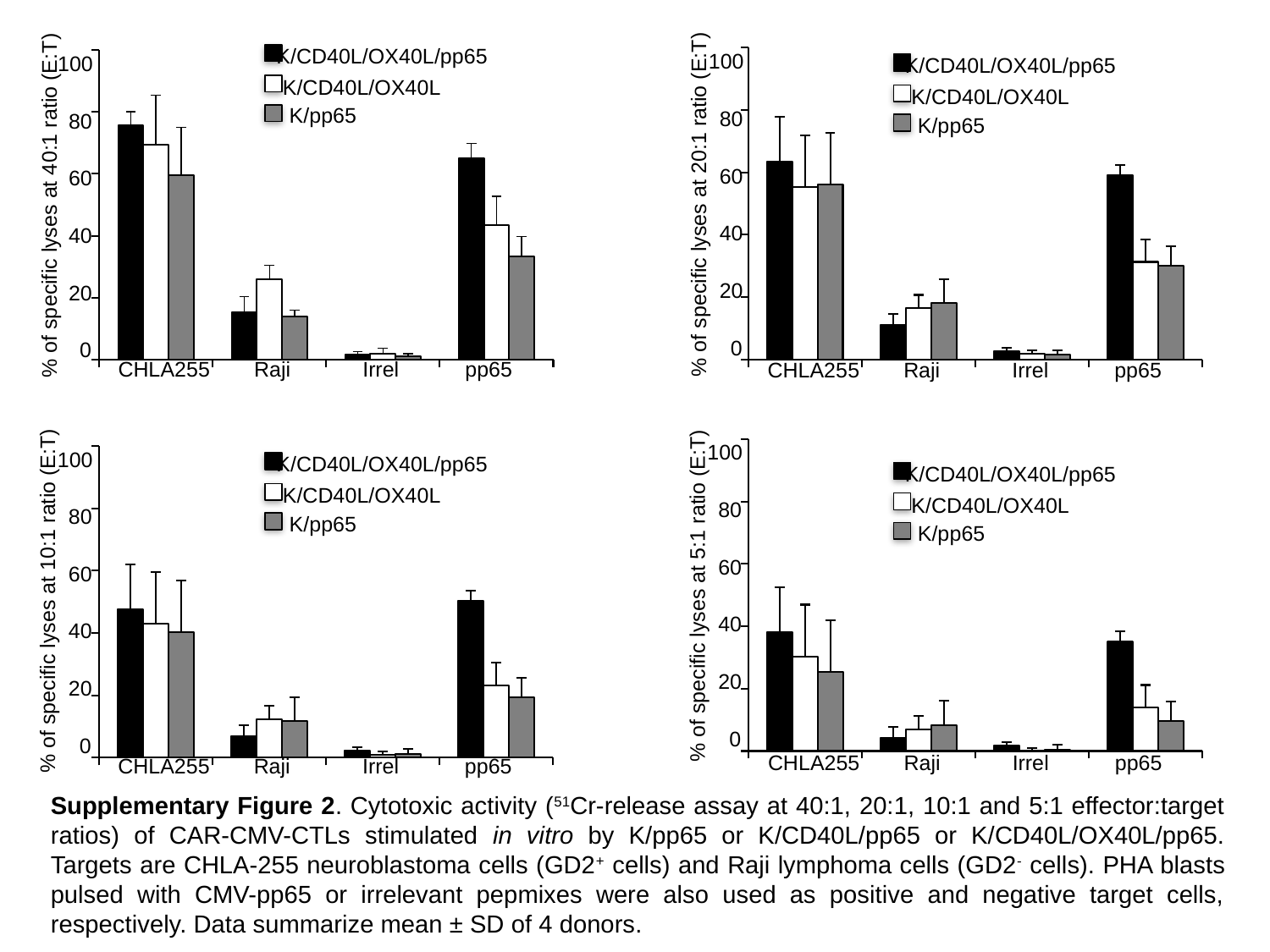
In the top-left chart (40:1 ratio), is the value for K/pp65 on pp65 greater or less than 40? less In the bottom-right chart, which series is shown with black bars? K/CD40L/OX40L/pp65 In the bottom-right chart (5:1 ratio), is the value for K/CD40L/OX40L/pp65 on CHLA255 greater or less than 20? greater What kind of chart is the top-left chart (40:1 ratio)? bar chart How many series does the legend of the top-right chart (20:1 ratio) list? 3 In the top-right chart (20:1 ratio), which target has the lowest K/CD40L/OX40L/pp65 bar? Irrel In the bottom-left chart (10:1 ratio), is the value for K/CD40L/OX40L/pp65 on pp65 greater or less than 40? greater In the top-left chart (40:1 ratio), which target has the highest K/CD40L/OX40L/pp65 bar? CHLA255 In the top-right chart (20:1 ratio), for the pp65 target, which is larger: K/CD40L/OX40L/pp65 or K/CD40L/OX40L? K/CD40L/OX40L/pp65 In the bottom-right chart (5:1 ratio), for the pp65 target, which is larger: K/CD40L/OX40L or K/pp65? K/CD40L/OX40L How many target categories are shown on the x axis of the top-left chart (40:1 ratio)? 4